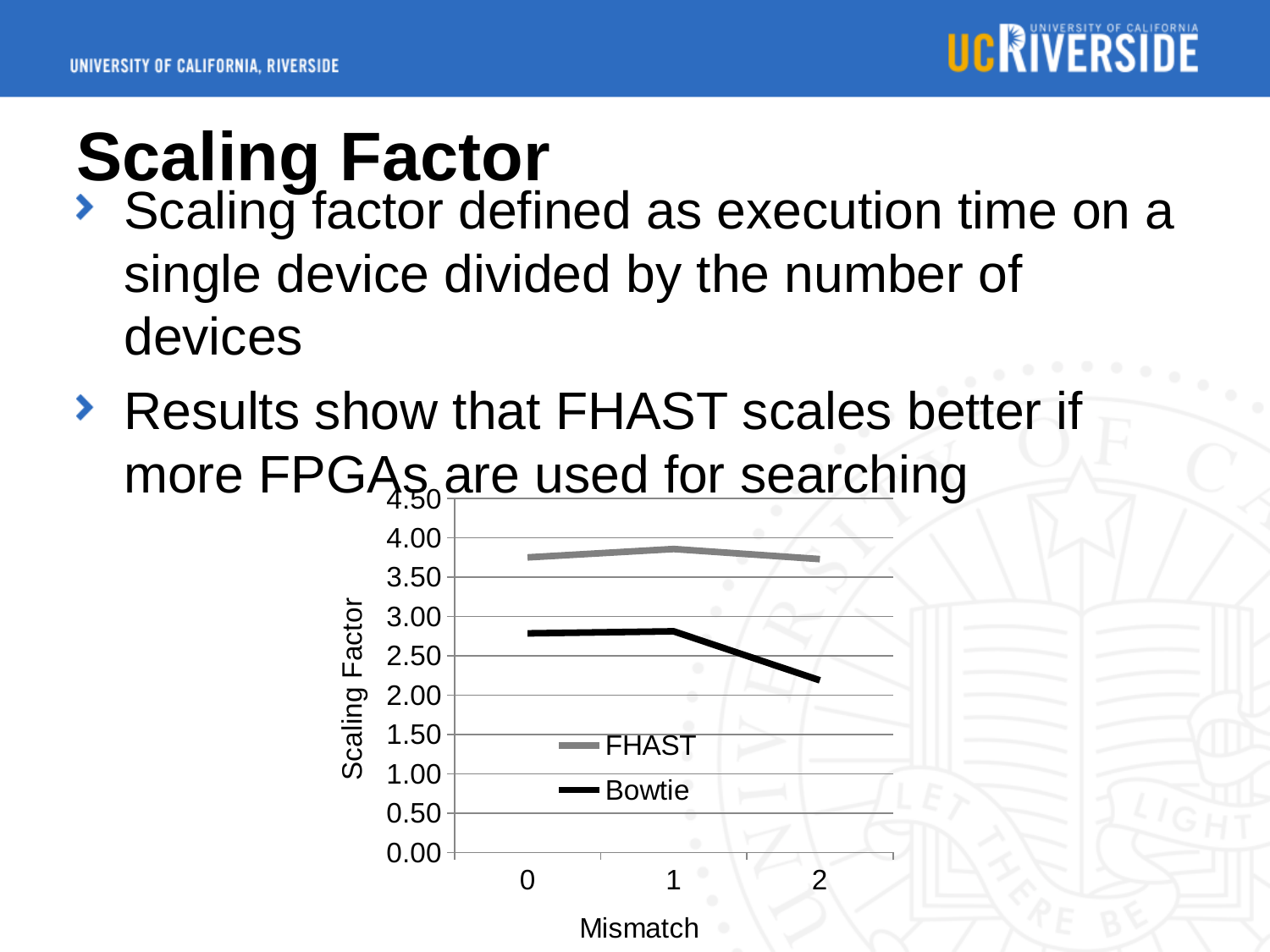
Is the Bowtie scaling factor at mismatch 2 greater or less than 2.50? less What is the title of the y axis? Scaling Factor How many mismatch values are plotted along the x axis? 3 Is the FHAST scaling factor at mismatch 0 greater or less than 3.50? greater At mismatch 2, which series has the higher scaling factor, FHAST or Bowtie? FHAST What kind of chart is shown on the slide? line chart Is the Bowtie scaling factor at mismatch 0 greater or less than 2.50? greater Which two series are listed in the chart legend? FHAST and Bowtie At which mismatch value is the Bowtie scaling factor lowest? 2 At mismatch 0, which series has the lower scaling factor, FHAST or Bowtie? Bowtie How many series does the chart legend list? 2 Does the Bowtie scaling factor rise or fall from mismatch 1 to mismatch 2? fall